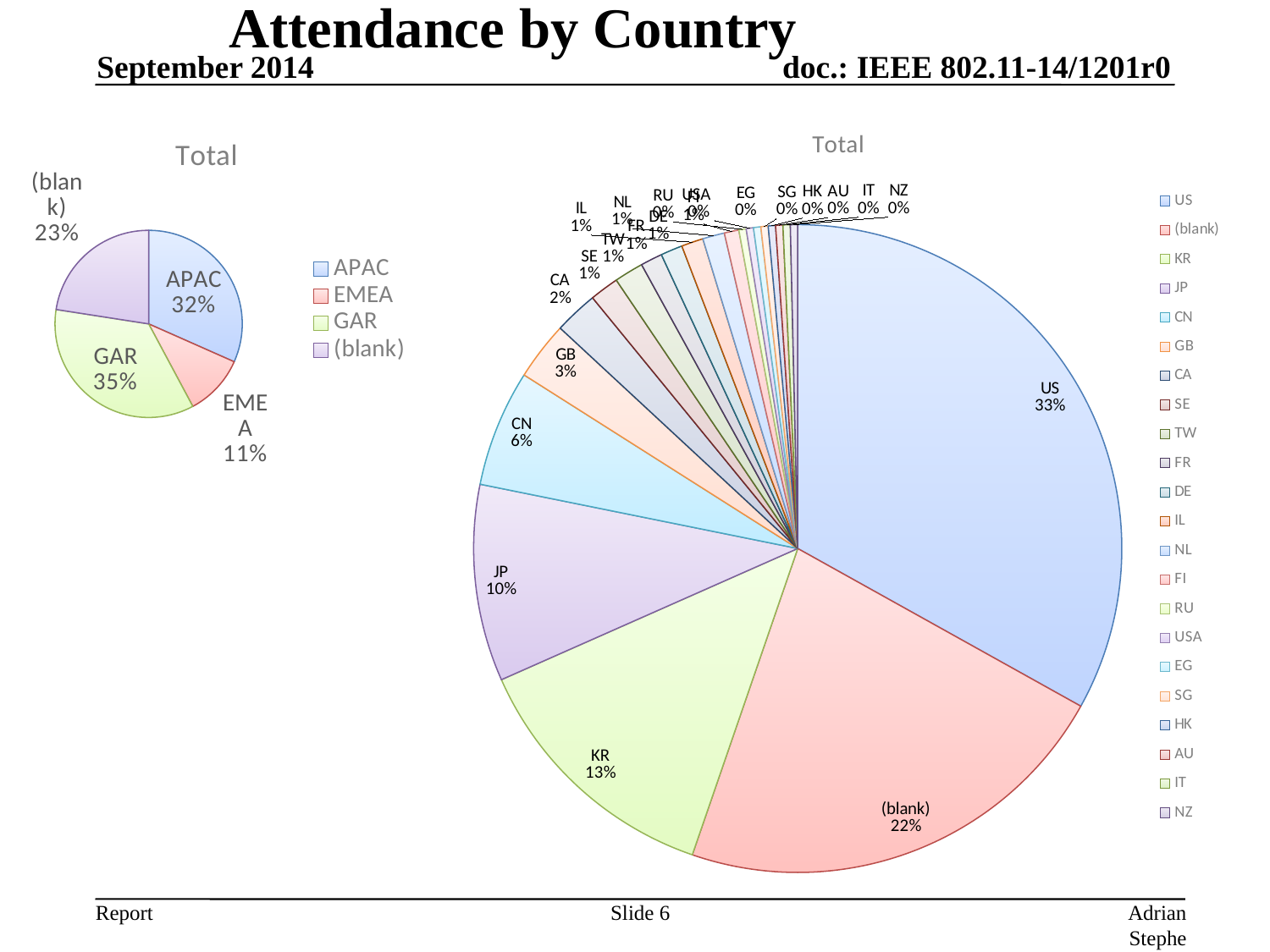
What type of chart is the larger chart on the right? Pie chart In the larger pie chart on the right, what share does US have? 33% In the larger pie chart on the right, how many entries does the legend list? 22 In the smaller pie chart on the left, which category has the largest share? GAR In the larger pie chart on the right, which is larger, the share for JP or the share for CN? JP In the smaller pie chart on the left, what share does EMEA have? 11% In the smaller pie chart on the left, what is the difference between the APAC and (blank) shares? 9% In the smaller pie chart on the left, which category has the smallest share? EMEA In the larger pie chart on the right, which country has the largest share? US In the smaller pie chart on the left, what share does GAR have? 35% In the smaller pie chart on the left, how many categories does the legend list? 4 In the larger pie chart on the right, what share does KR have? 13%